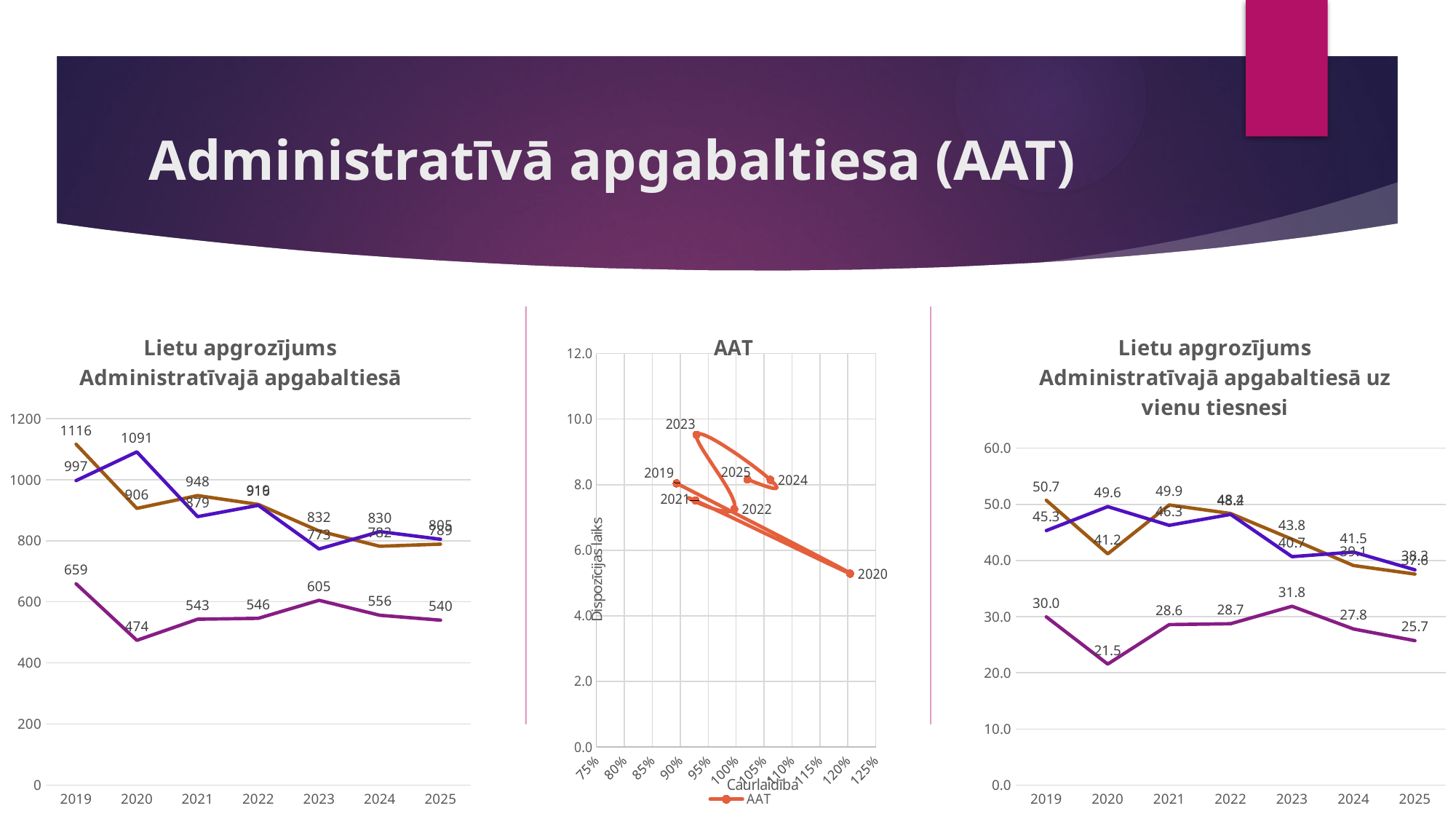
In the right chart 'Lietu apgrozījums Administratīvajā apgabaltiesā uz vienu tiesnesi', what is the value of the purple line in 2023? 31.8 In the left chart 'Lietu apgrozījums Administratīvajā apgabaltiesā', how many years are shown on the x axis? 7 What kind of chart is the left chart titled 'Lietu apgrozījums Administratīvajā apgabaltiesā'? line chart In the left chart 'Lietu apgrozījums Administratīvajā apgabaltiesā', what is the difference between the purple line's 2019 value and its 2020 value? 185 In the left chart 'Lietu apgrozījums Administratīvajā apgabaltiesā', in which year is the purple line at its lowest? 2020 In the left chart 'Lietu apgrozījums Administratīvajā apgabaltiesā', what is the value of the purple line in 2019? 659 In the middle chart 'AAT', how many series does the legend list? 1 In the left chart 'Lietu apgrozījums Administratīvajā apgabaltiesā', what is the highest value shown on any line? 1116 In the middle chart 'AAT', is the Caurlaidība for 2020 greater or less than 110%? greater In the middle chart 'AAT', which year has the highest Dispozīcijas laiks? 2023 In the middle chart 'AAT', what is the label of the x axis? Caurlaidība In the right chart 'Lietu apgrozījums Administratīvajā apgabaltiesā uz vienu tiesnesi', does the purple line rise or fall from 2023 to 2025? fall